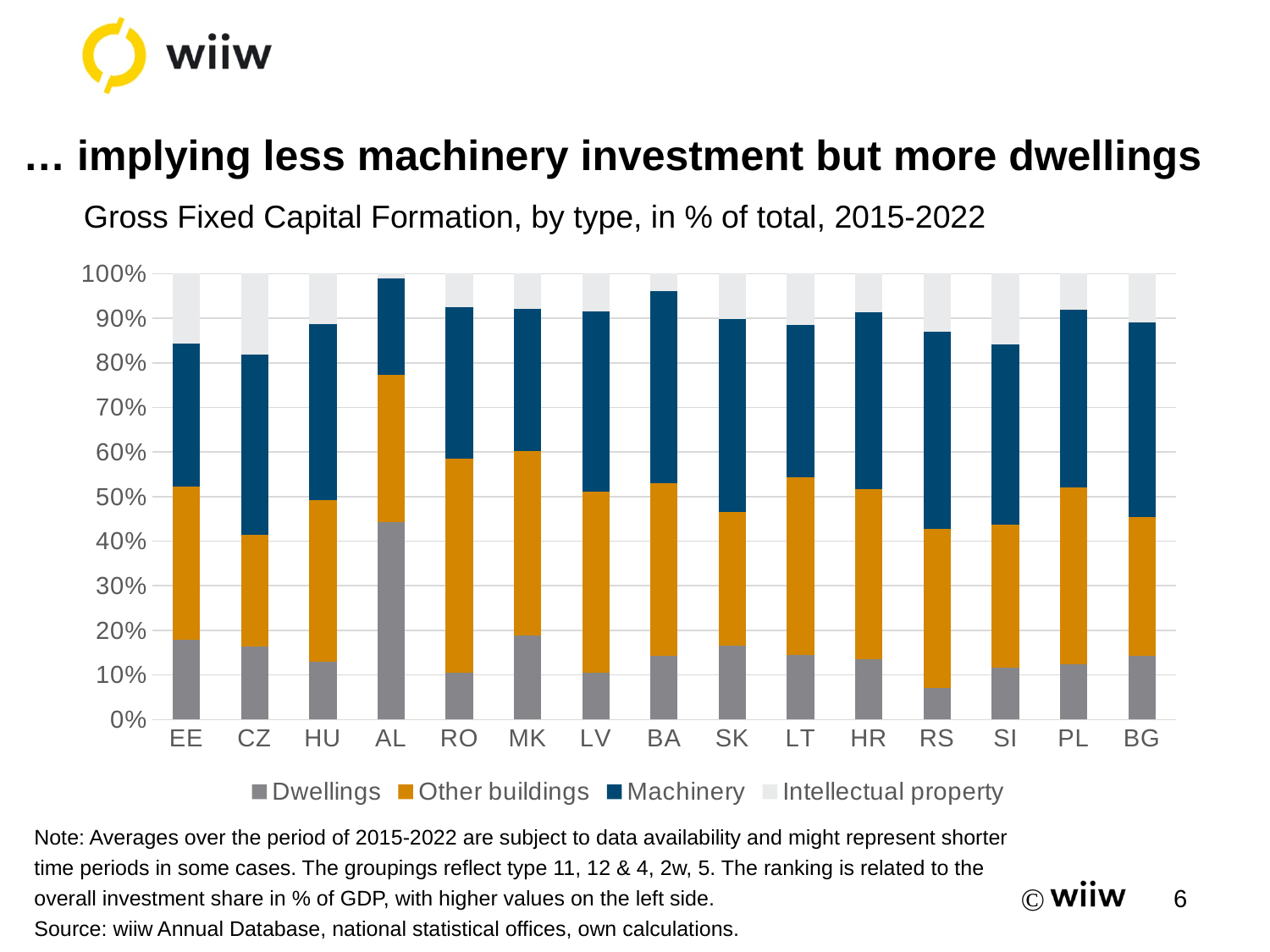
What is the subtitle of the chart? Gross Fixed Capital Formation, by type, in % of total, 2015-2022 How many countries are shown on the x axis of the chart? 15 Is the top of the Other buildings segment for CZ greater or less than 50%? less Is the Dwellings share for RS greater or less than 10%? less What kind of chart is shown on the slide? Stacked bar chart Is the Dwellings share for AL greater or less than 40%? greater Which country has the smallest Dwellings share? RS Which has the larger Dwellings share, EE or RO? EE Which country has the largest Dwellings share? AL How many series does the legend list? 4 Which country has the smallest Intellectual property share? AL